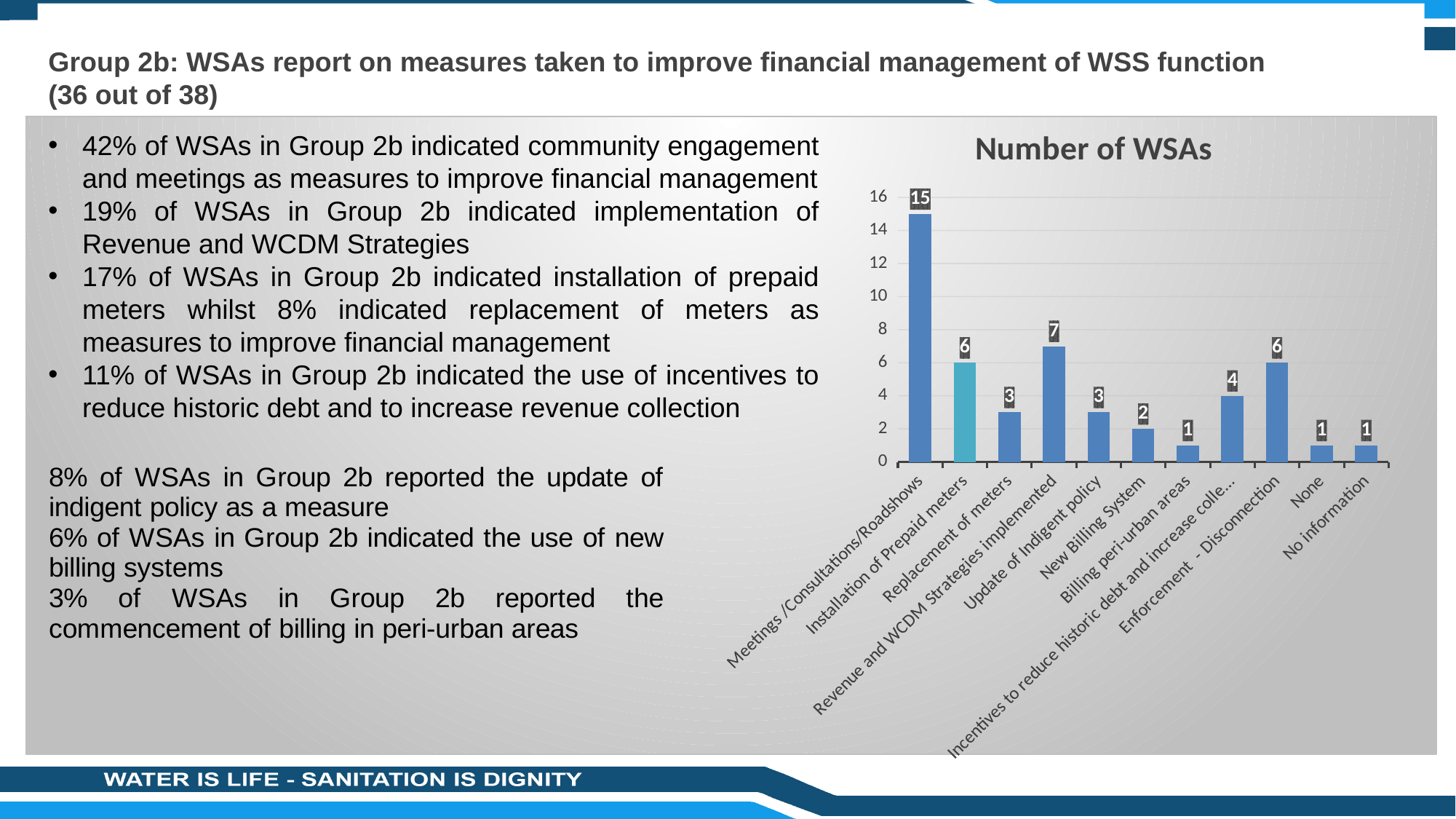
How many categories are shown on the x axis? 11 Is the value for Meetings /Consultations/Roadshows greater or less than 10? greater What is the value for Installation of Prepaid meters? 6 Which category has the highest number of WSAs? Meetings /Consultations/Roadshows What is the value for Enforcement - Disconnection? 6 What is the title of the chart? Number of WSAs What is the value for New Billing System? 2 What kind of chart is shown? Bar chart What is the value for Revenue and WCDM Strategies implemented? 7 Which is larger, Replacement of meters or Enforcement - Disconnection? Enforcement - Disconnection What is the value for Meetings /Consultations/Roadshows? 15 What is the difference between Meetings /Consultations/Roadshows and Revenue and WCDM Strategies implemented? 8